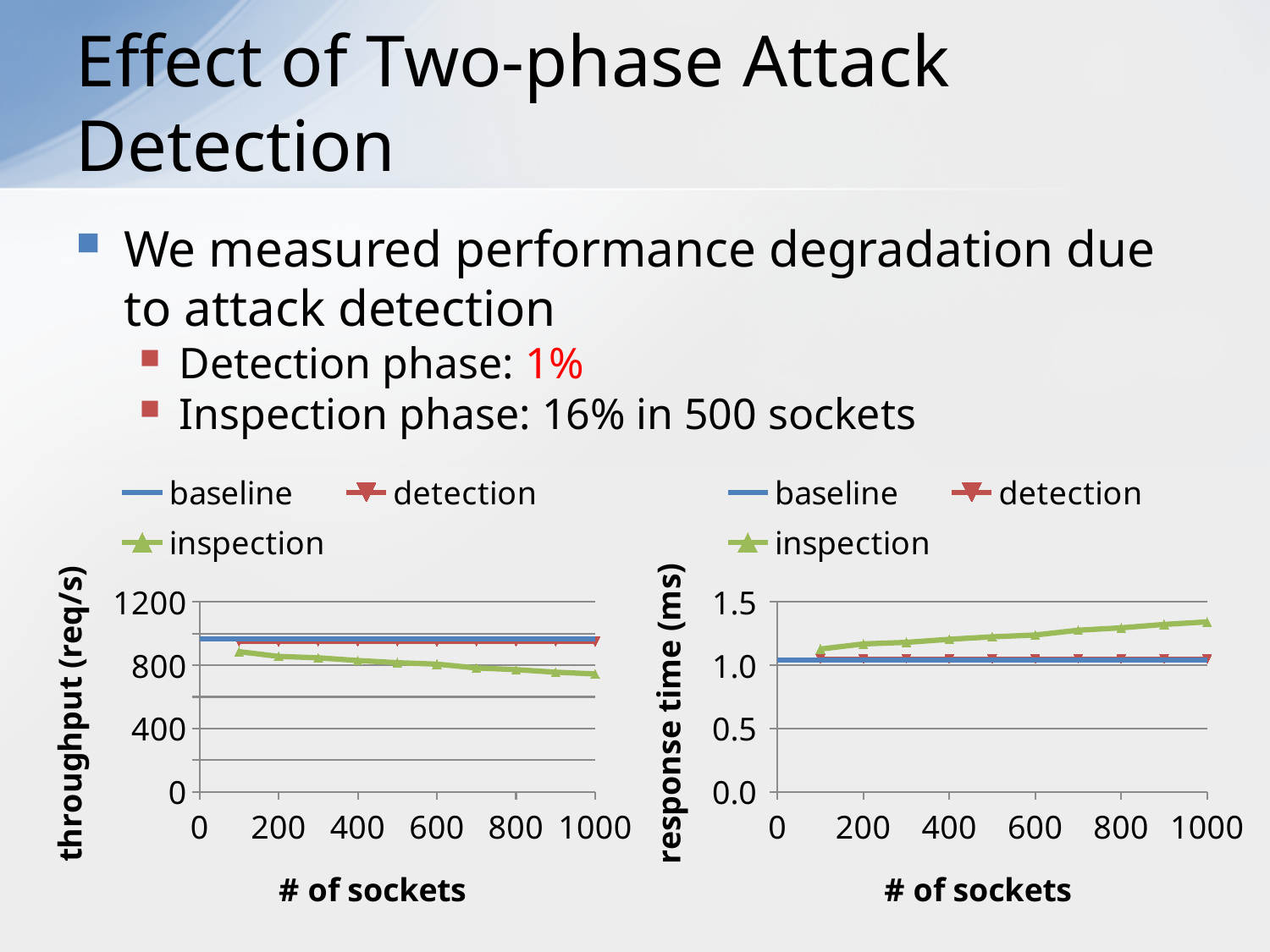
How many series does the legend of the left chart list? 3 How many series does the legend of the right chart list? 3 In the left chart, is the throughput of the baseline series at 1000 sockets greater or less than 800? greater In the right chart, does the inspection series rise or fall as the number of sockets increases? rise In the right chart, at 1000 sockets, which series has the higher response time, baseline or inspection? inspection What kind of chart is the right chart (response time vs. # of sockets)? line chart What kind of chart is the left chart (throughput vs. # of sockets)? line chart In the left chart, does the inspection series rise or fall as the number of sockets increases? fall In the left chart, is the throughput of the inspection series at 1000 sockets greater or less than 800? less In the left chart, at 1000 sockets, which series has the higher throughput, baseline or inspection? baseline In the right chart, is the response time of the inspection series at 1000 sockets greater or less than 1.0? greater What is the y-axis label of the right chart? response time (ms)